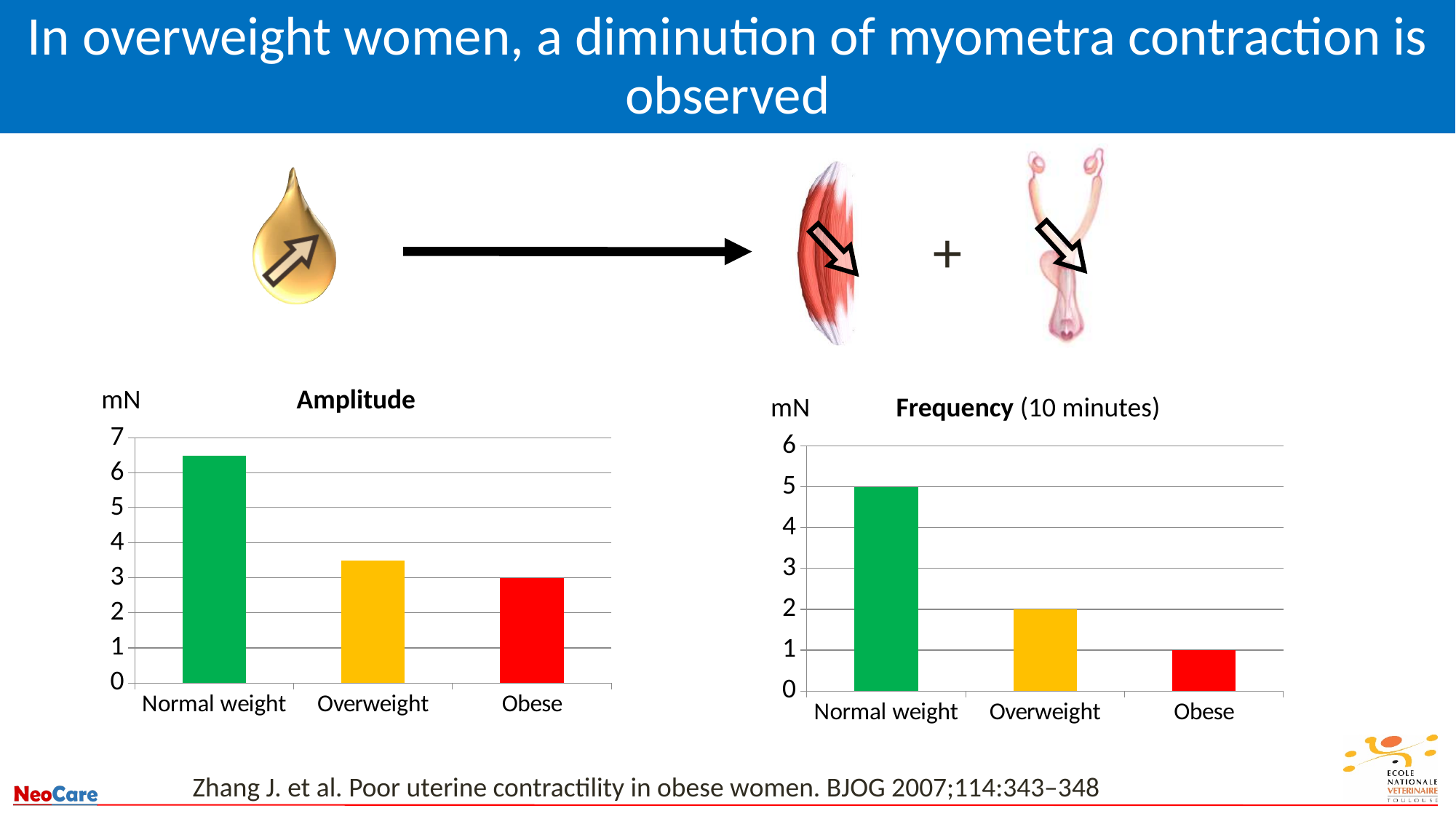
In the Frequency (10 minutes) chart, what colour is the Overweight bar? yellow In the Frequency (10 minutes) chart, what is the value for Normal weight? 5 What kind of chart is the Amplitude chart? bar chart In the Amplitude chart, what is the value for Obese? 3 In the Amplitude chart, which category has the lowest value? Obese In the Amplitude chart, which category has the highest value? Normal weight In the Amplitude chart, is the value for Normal weight greater or less than 6? greater How many categories are shown in the Amplitude chart? 3 In the Amplitude chart, is the value for Overweight greater or less than 4? less In the Frequency (10 minutes) chart, do the values rise or fall from Normal weight to Obese? fall In the Frequency (10 minutes) chart, what is the difference between Normal weight and Overweight? 3 In the Frequency (10 minutes) chart, what is the value for Obese? 1